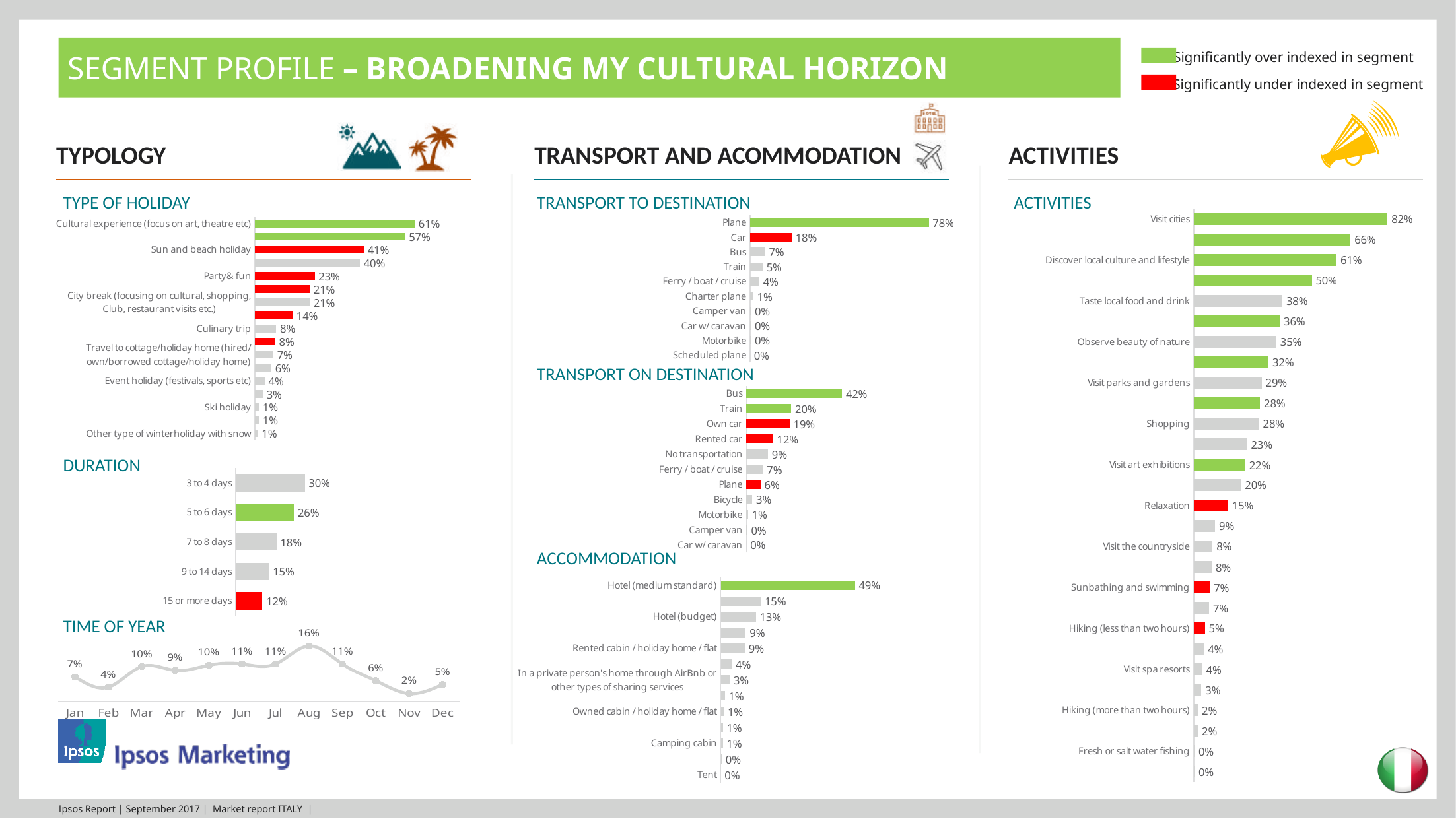
In the Time of Year chart, what is the value for Nov? 2% What kind of chart is the Time of Year chart? Line chart In the Activities chart, what is the value for Visit cities? 82% In the Time of Year chart, how many months are plotted? 12 In the Accommodation chart, what is the value for Hotel (medium standard)? 49% In the Duration chart, what is the difference between the values for 3 to 4 days and 15 or more days? 18% In the Transport on Destination chart, what is the difference between the values for Train and Rented car? 8% In the Transport to Destination chart, what is the value for Plane? 78% In the Transport on Destination chart, which category has the highest value? Bus In the Duration chart, what is the value for 5 to 6 days? 26% In the Activities chart, which is larger, the value for Shopping or the value for Relaxation? Shopping In the Time of Year chart, which month has the highest value? Aug